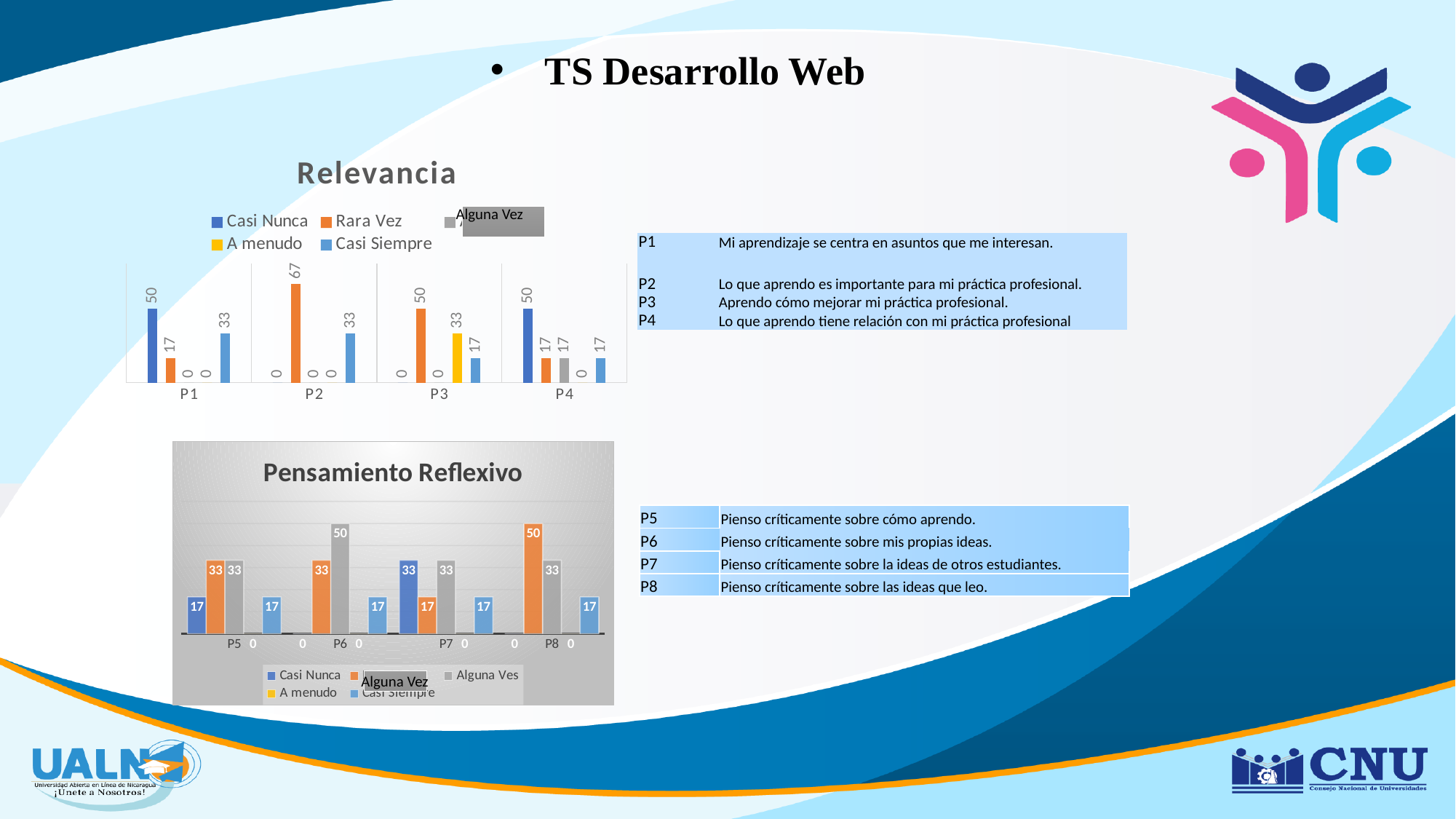
In the Relevancia chart, how many categories are shown on the x axis? 4 In the Relevancia chart, what is the value for A menudo at P3? 33 What type of chart is the Pensamiento Reflexivo chart? Bar chart In the Pensamiento Reflexivo chart, what is the difference between Alguna Ves at P6 and Casi Siempre at P6? 33 In the Relevancia chart, what is the difference between Rara Vez at P2 and Casi Siempre at P2? 34 In the Pensamiento Reflexivo chart, what is the value for Casi Nunca at P7? 33 In the Pensamiento Reflexivo chart, which is larger at P5: Casi Nunca or Casi Siempre? They are equal (17) In the Relevancia chart, which category has the highest single bar? P2 In the Relevancia chart, what is the value for Casi Nunca at P1? 50 In the Pensamiento Reflexivo chart, what is the value for Alguna Ves at P6? 50 In the Relevancia chart, how many series does the legend list? 5 In the Relevancia chart, what is the value for Rara Vez at P2? 67